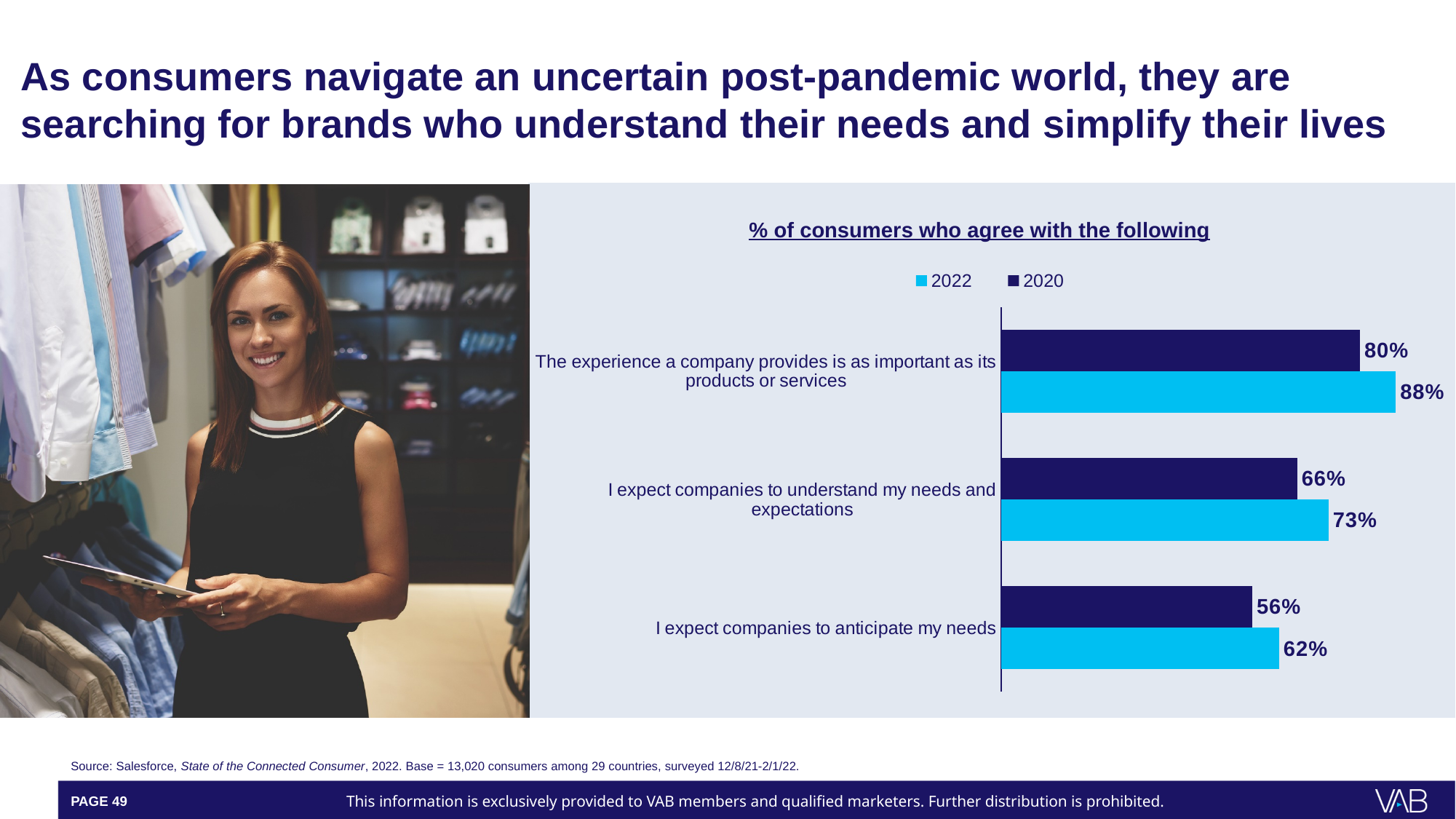
What is the difference between the 2022 and 2020 values for 'The experience a company provides is as important as its products or services'? 8 percentage points How many series does the legend list? 2 What percentage of consumers agreed in 2022 that the experience a company provides is as important as its products or services? 88% What percentage of consumers agreed in 2020 that they expect companies to understand their needs and expectations? 66% What type of chart is shown on the slide? Bar chart For 'I expect companies to anticipate my needs', which year had the higher value, 2020 or 2022? 2022 What is the title of the chart? % of consumers who agree with the following Which statement had the highest share of agreement in 2022? The experience a company provides is as important as its products or services By how many percentage points did agreement with 'I expect companies to understand my needs and expectations' change from 2020 to 2022? 7 percentage points What was the 2022 value for 'I expect companies to anticipate my needs'? 62% Which statement had the lowest share of agreement in 2020? I expect companies to anticipate my needs How many statements are shown in the chart? 3